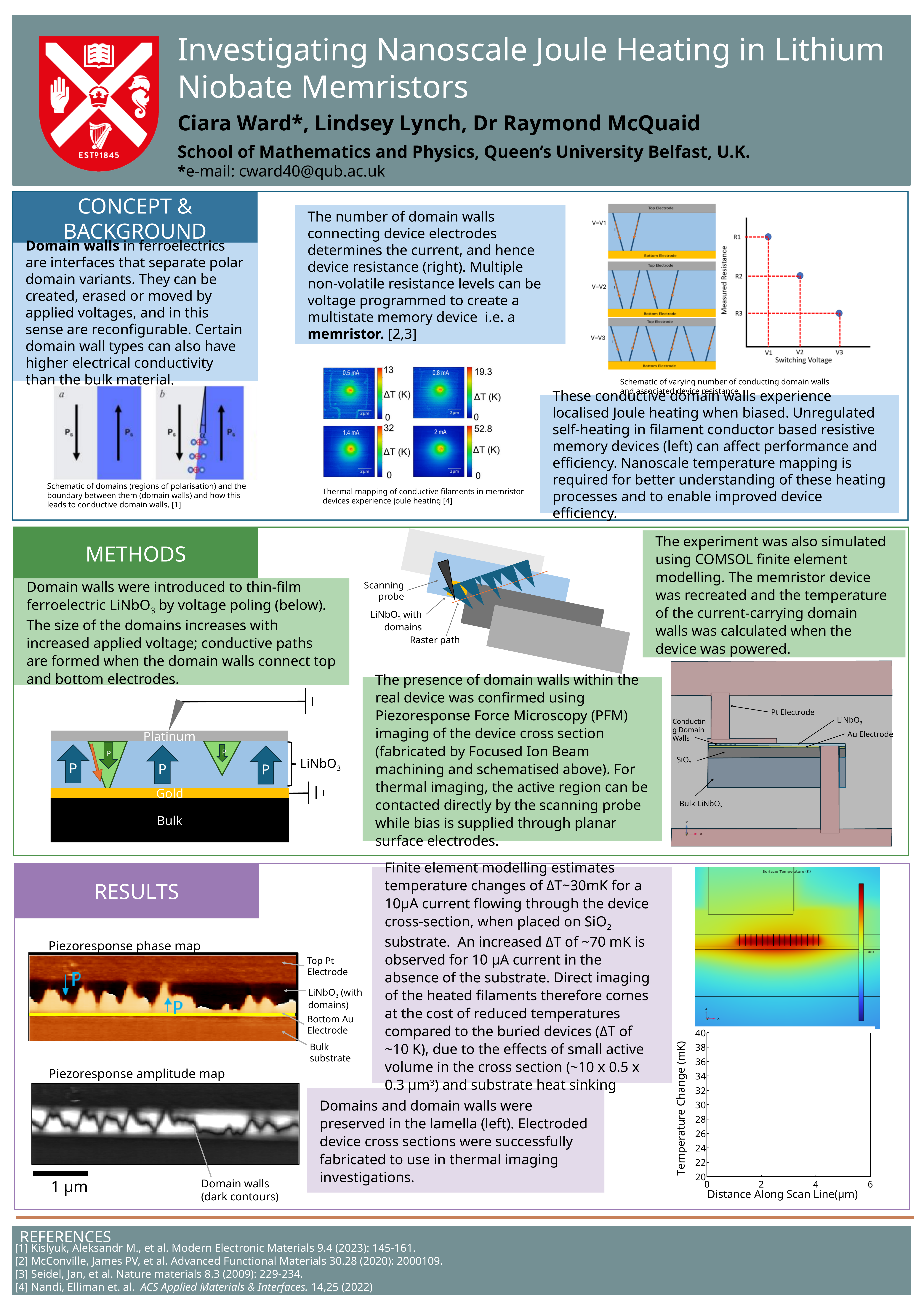
In the thermal mapping panels, what is the maximum ΔT (K) on the colour scale for the 0.5 mA panel? 13 In the Measured Resistance versus Switching Voltage chart, how many data points are plotted? 3 In the Measured Resistance versus Switching Voltage chart, which switching voltage corresponds to the highest measured resistance? V1 In the thermal mapping panels, which current has the larger colour-scale maximum ΔT, 0.8 mA or 1.4 mA? 1.4 mA In the chart at the bottom right of the slide, what is the highest value shown on the y axis? 40 In the chart at the bottom right of the slide, what is the label of the y axis? Temperature Change (mK) In the Measured Resistance versus Switching Voltage chart, does the measured resistance rise or fall as the switching voltage increases from V1 to V3? fall In the chart at the bottom right of the slide, what is the highest value shown on the x axis? 6 In the Measured Resistance versus Switching Voltage chart, which switching voltage corresponds to the lowest measured resistance? V3 In the thermal mapping panels, what is the maximum ΔT (K) on the colour scale for the 2 mA panel? 52.8 In the Measured Resistance versus Switching Voltage chart, which resistance level is plotted at V2? R2